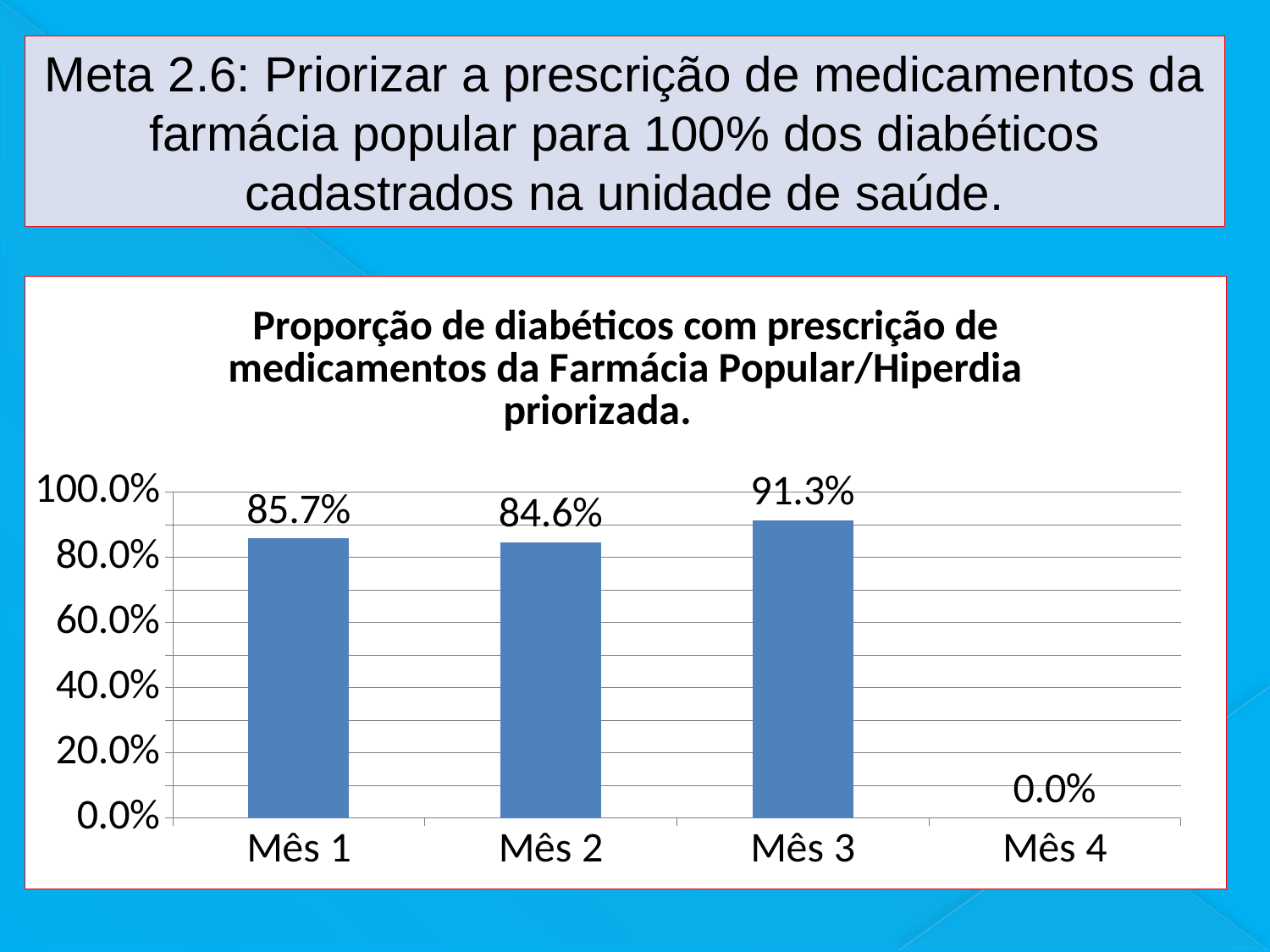
Which month has the lowest value? Mês 4 Is the value for Mês 3 greater or less than 80.0%? greater Which is larger, the value for Mês 1 or the value for Mês 2? Mês 1 What is the title of the chart? Proporção de diabéticos com prescrição de medicamentos da Farmácia Popular/Hiperdia priorizada. What is the value for Mês 2? 84.6% What kind of chart is shown on the slide? bar chart Which month has the highest value? Mês 3 What is the value for Mês 3? 91.3% What is the value for Mês 1? 85.7% What is the value for Mês 4? 0.0% What is the difference between the values for Mês 3 and Mês 1? 5.6% How many categories are shown on the x axis? 4